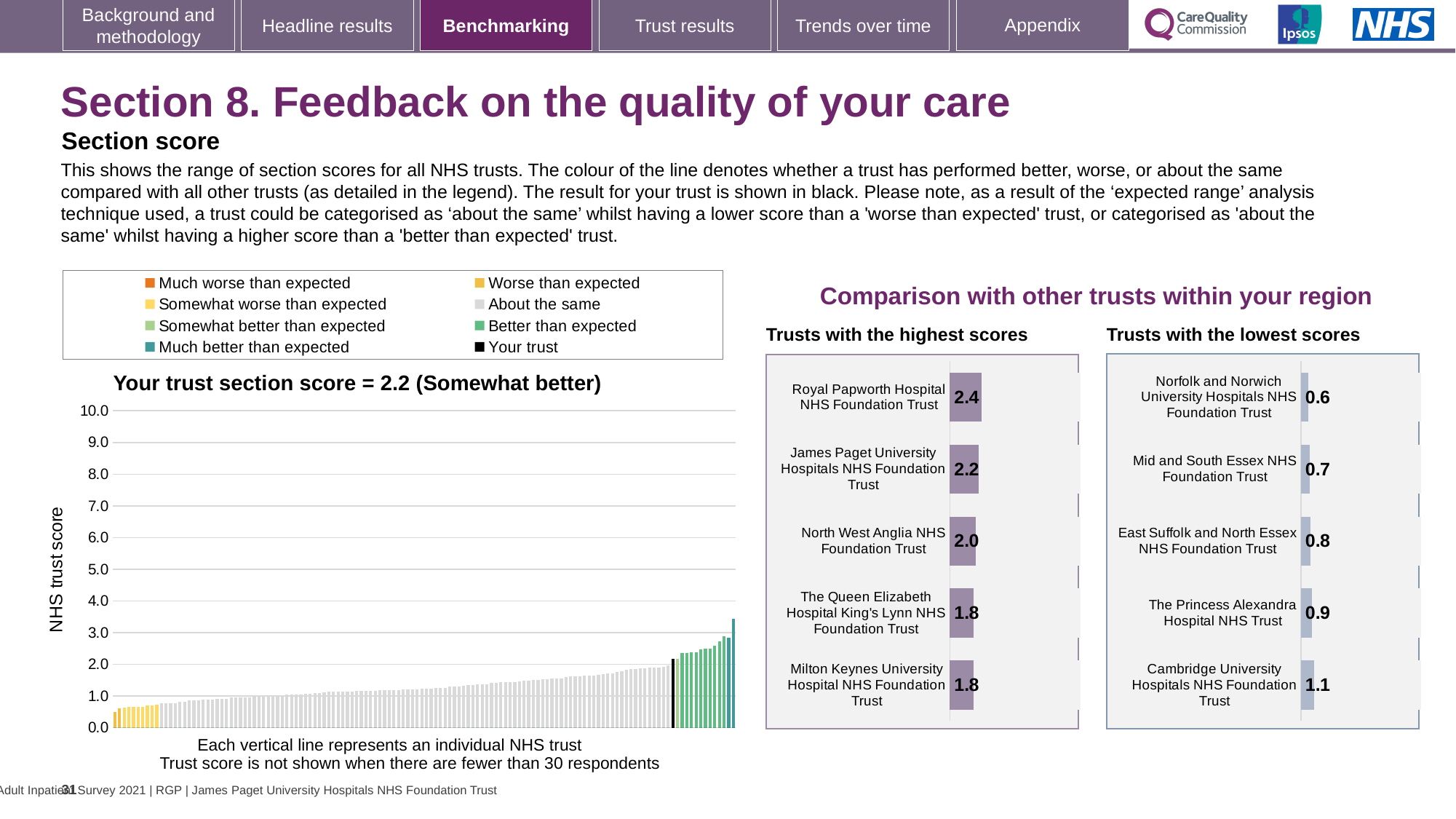
In the 'Trusts with the highest scores' chart, what is the score for Royal Papworth Hospital NHS Foundation Trust? 2.4 In the 'Trusts with the lowest scores' chart, which trust has the lowest score? Norfolk and Norwich University Hospitals NHS Foundation Trust In the 'Trusts with the lowest scores' chart, what is the score for Mid and South Essex NHS Foundation Trust? 0.7 In the 'Trusts with the lowest scores' chart, which has the larger score: Cambridge University Hospitals NHS Foundation Trust or East Suffolk and North Essex NHS Foundation Trust? Cambridge University Hospitals NHS Foundation Trust In the 'Trusts with the highest scores' chart, which trust has the highest score? Royal Papworth Hospital NHS Foundation Trust In the 'Your trust section score' chart, do the trust scores rise or fall from left to right? Rise How many trusts are shown in the 'Trusts with the lowest scores' chart? 5 What kind of chart is the 'Your trust section score' chart? Bar chart In the 'Trusts with the highest scores' chart, what is the difference between the scores of Royal Papworth Hospital NHS Foundation Trust and Milton Keynes University Hospital NHS Foundation Trust? 0.6 In the 'Trusts with the highest scores' chart, what is the score for North West Anglia NHS Foundation Trust? 2.0 How many entries does the legend above the 'Your trust section score' chart list? 8 According to the title of the 'Your trust section score' chart, what is the section score for your trust? 2.2 (Somewhat better)